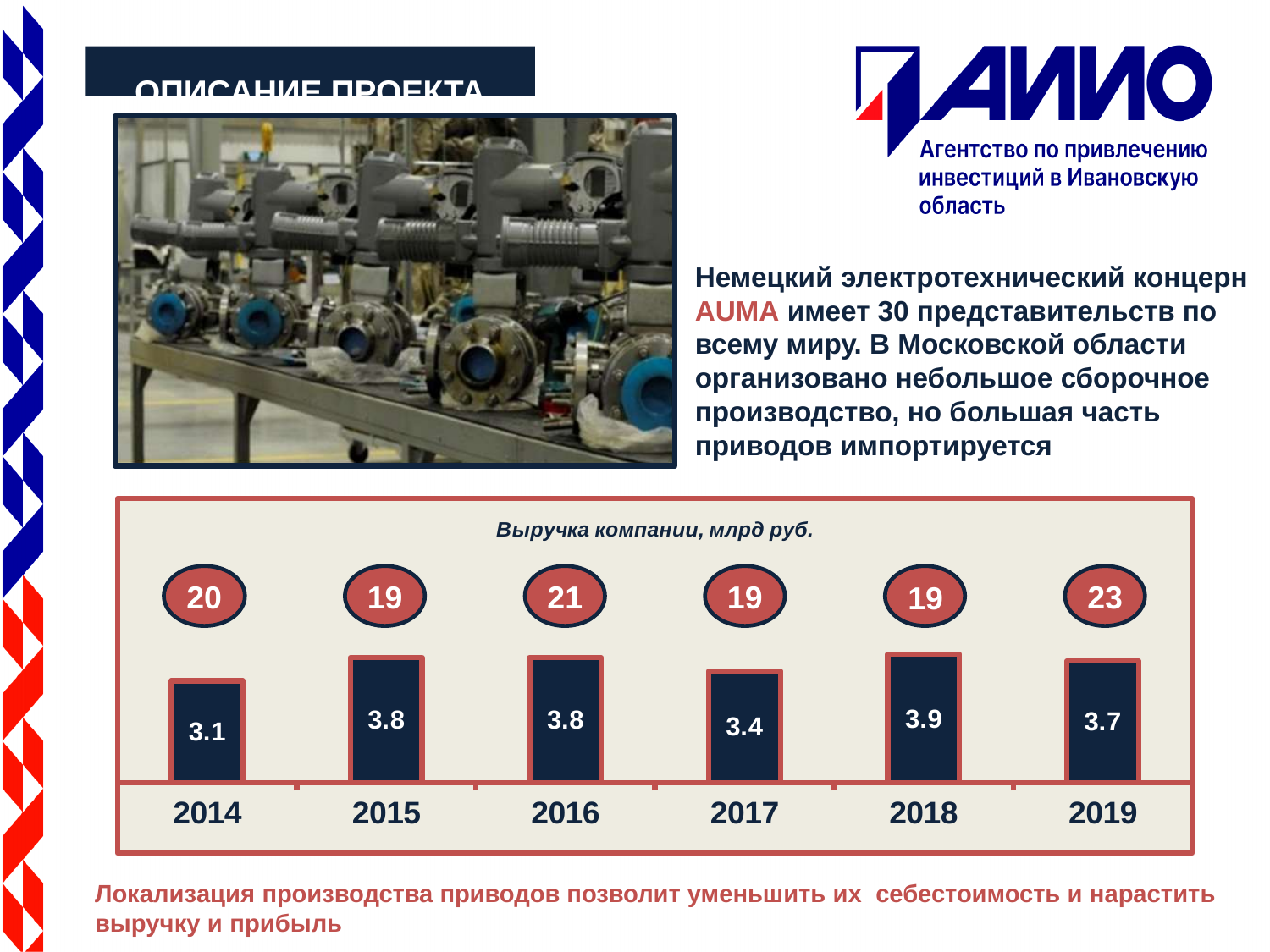
What is the difference between the bar values for 2018 and 2014? 0.8 What type of chart is shown on the slide? bar chart Which bar is larger, 2015 or 2017? 2015 Which year has the lowest bar value? 2014 What number is shown in the circle above the 2016 bar? 21 What is the value of the bar for 2014? 3.1 What is the value of the bar for 2017? 3.4 What is the title of the chart on the slide? Выручка компании, млрд руб. How many years are shown on the x axis of the chart? 6 Which year has the highest bar value? 2018 What is the value of the bar for 2019? 3.7 What number is shown in the circle above the 2019 bar? 23